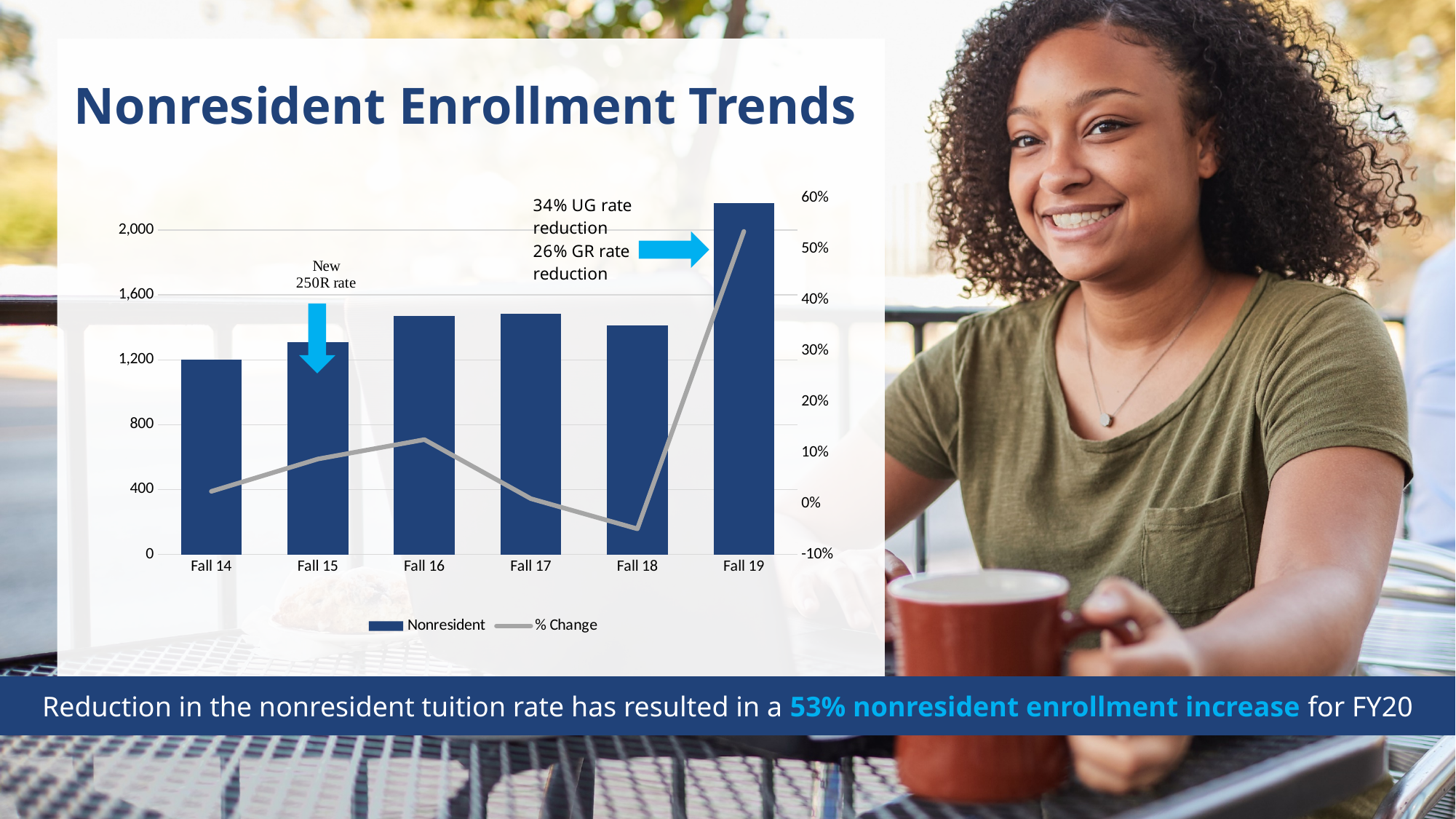
How many series does the chart legend list? 2 Is the % Change value for Fall 19 greater or less than 50%? greater How many categories are shown on the x axis of the chart? 6 Is the Nonresident bar for Fall 19 larger or smaller than the bar for Fall 18? larger Is the Nonresident value for Fall 16 greater or less than 1,600? less Which term has the lowest point on the % Change line? Fall 18 What kind of chart is shown on the slide? A combination bar and line chart Which term has the lowest Nonresident enrollment bar? Fall 14 Is the Nonresident value for Fall 18 greater or less than 1,200? greater Which term has the highest Nonresident enrollment bar? Fall 19 What are the two entries in the chart legend? Nonresident and % Change